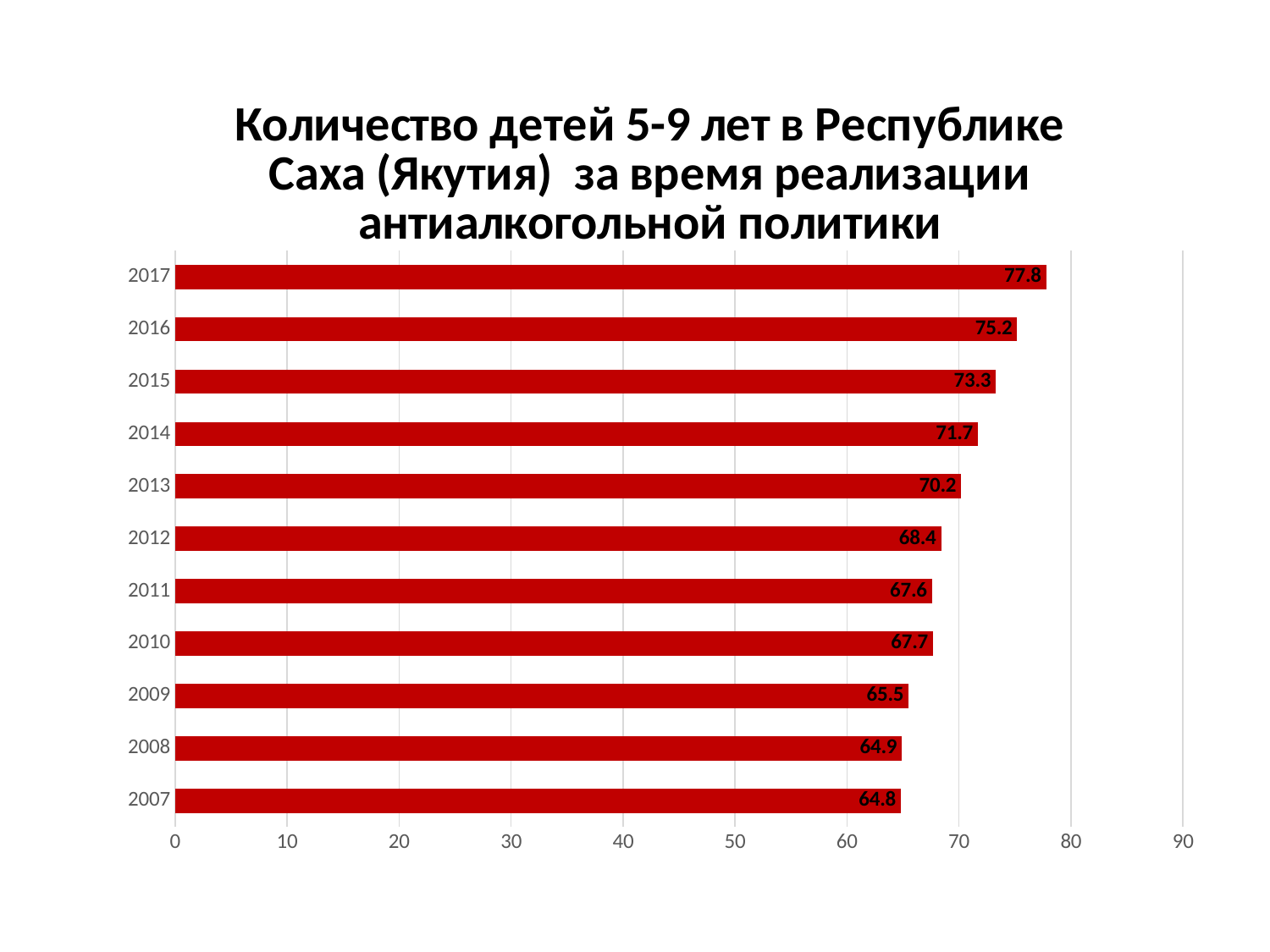
What is the value for 2017? 77.8 What is the difference between the values for 2017 and 2007? 13 What is the value for 2007? 64.8 What is the value for 2013? 70.2 Which year has the lowest value? 2007 What kind of chart is this? bar chart What is the difference between the values for 2016 and 2015? 1.9 Which is larger, the value for 2014 or the value for 2012? 2014 How many years are shown on the chart? 11 Is the value for 2009 greater or less than 70? less Do the values generally rise or fall from 2007 to 2017? rise Which year has the highest value? 2017